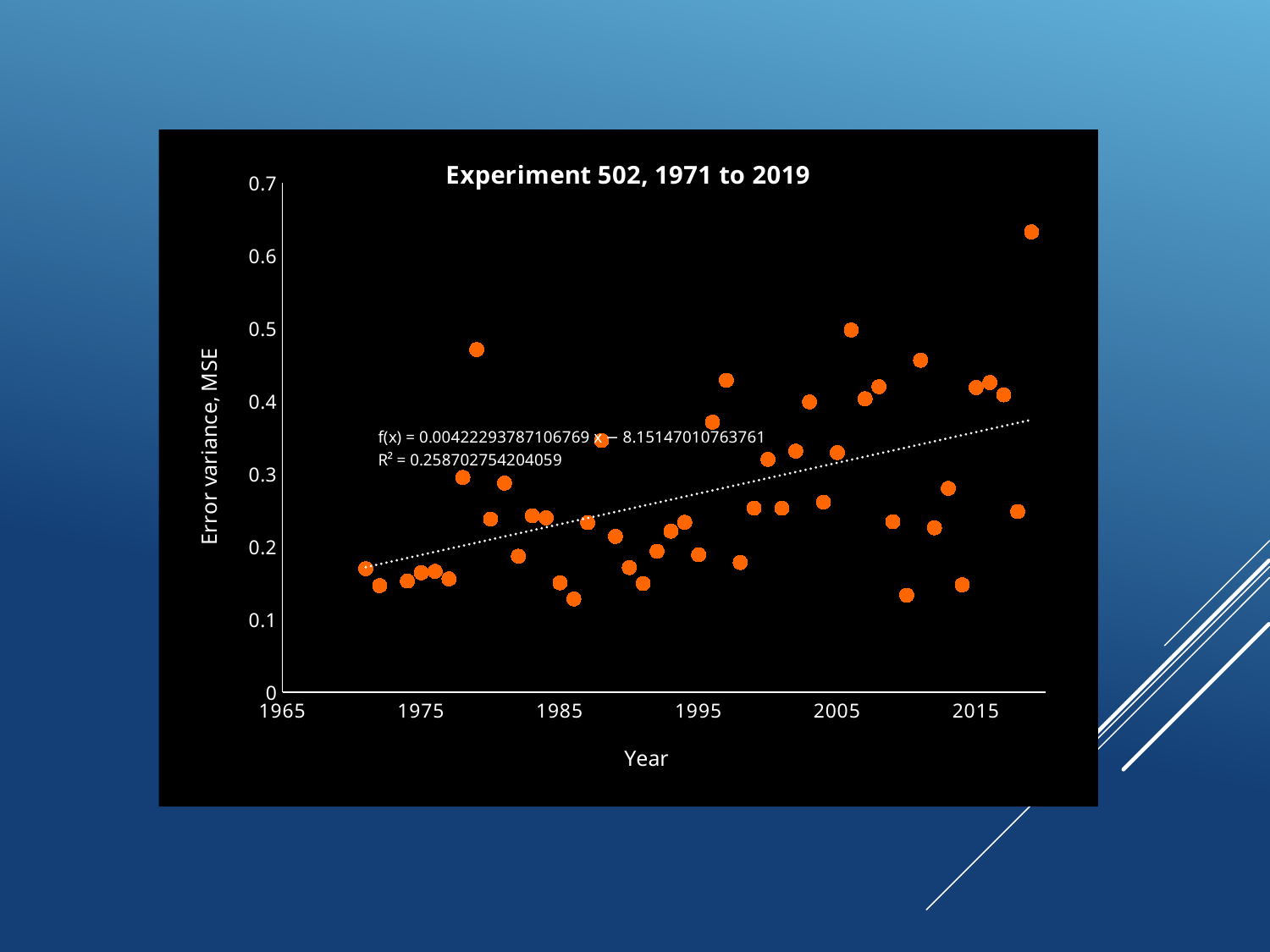
What kind of chart is shown on the slide? Scatter chart What is the title of the chart? Experiment 502, 1971 to 2019 What R² value is printed for the trendline on the chart? 0.258702754204059 Is the error variance value for 1985 greater or less than 0.2? less Which has the larger error variance, 1979 or 1971? 1979 Is the error variance value for 1997 greater or less than 0.4? greater Do the error variance values generally rise or fall as the year increases along the x axis? Rise In which year does the error variance reach its highest value? 2019 Is the error variance value for 1979 greater or less than 0.4? greater What is the label of the vertical axis? Error variance, MSE